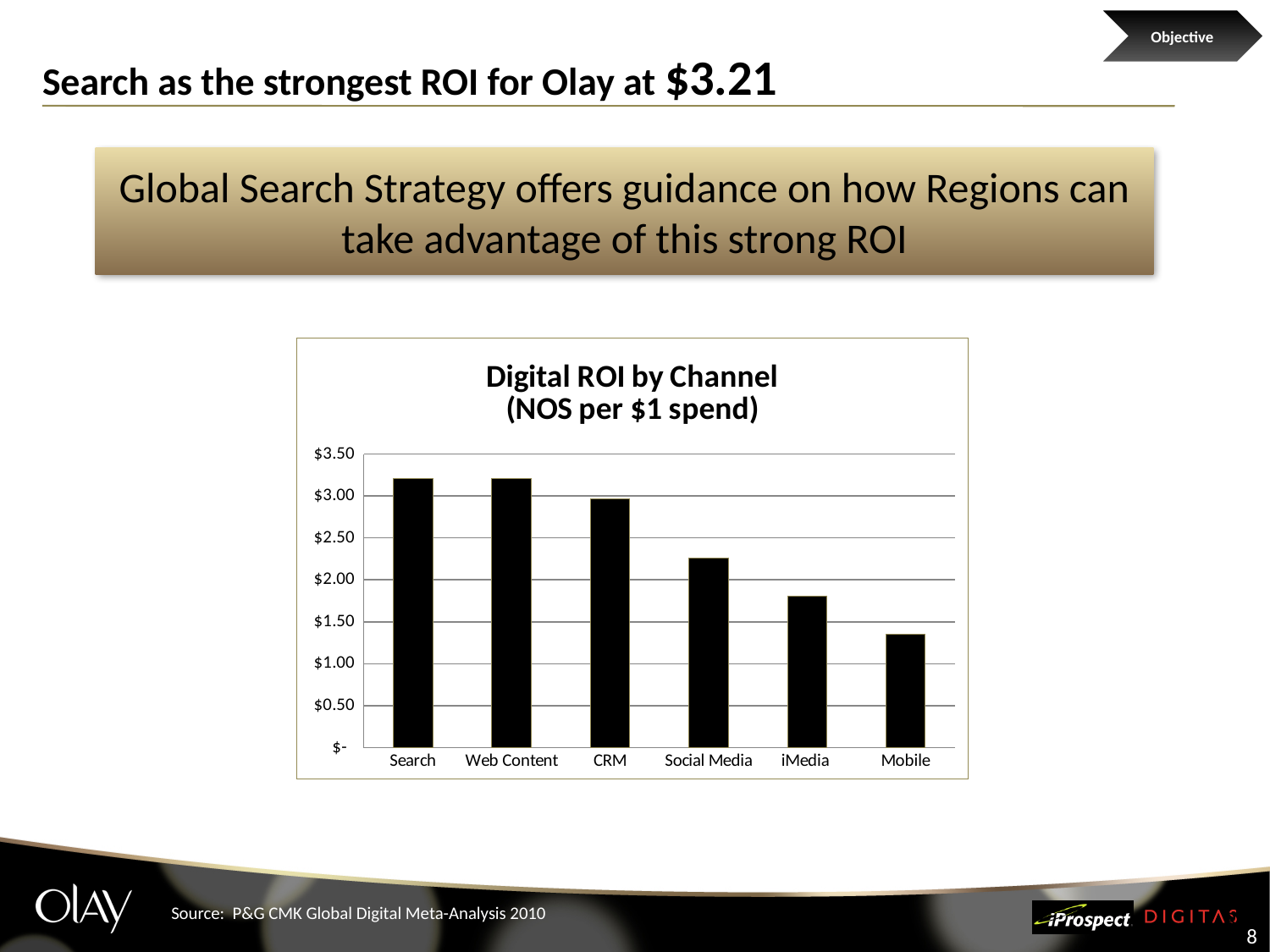
Which has a higher ROI, CRM or Social Media? CRM Do the values rise or fall moving from Search to Mobile along the x axis? fall How many channels are shown on the x axis of the chart? 6 Is the value for Mobile greater or less than $1.50? less What is the title of the chart? Digital ROI by Channel (NOS per $1 spend) Is the value for CRM greater or less than $2.50? greater What type of chart is shown on the slide? bar chart Is the value for Social Media greater or less than $2.00? greater Which has a higher ROI, iMedia or Mobile? iMedia According to the slide, what is the ROI for Search? $3.21 Which channel has the lowest digital ROI in the chart? Mobile